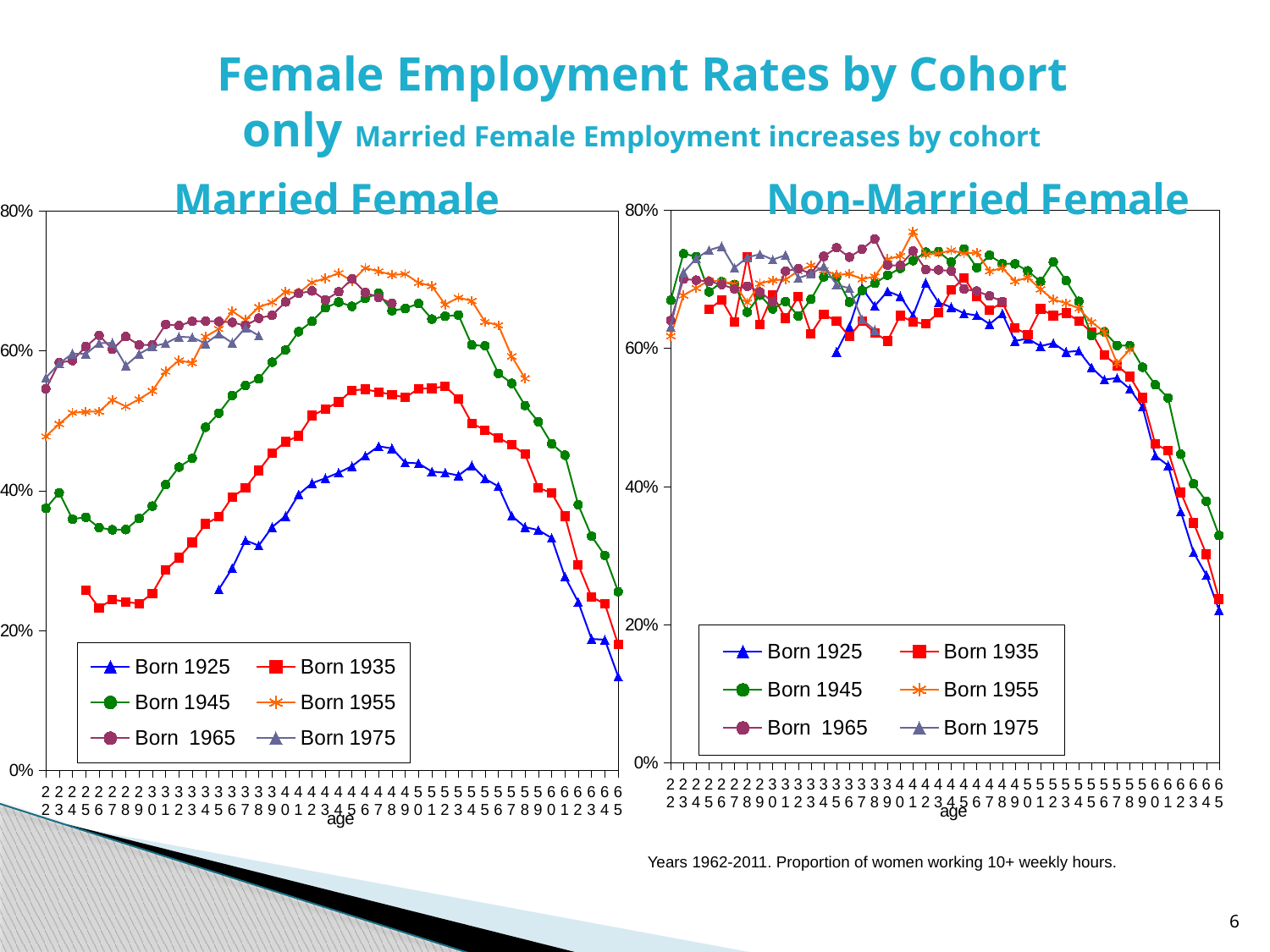
What kind of chart is the Married Female chart? line chart How many series does the legend of the Non-Married Female chart list? 6 In the Non-Married Female chart, which is larger at age 65: Born 1945 or Born 1925? Born 1945 In the Married Female chart, which is larger at age 40: Born 1945 or Born 1935? Born 1945 In the Married Female chart, does the Born 1935 series rise or fall between age 30 and age 45? rise In the Married Female chart, which series has the highest value at age 65? Born 1945 In the Married Female chart, is the value for Born 1955 at age 45 greater or less than 60%? greater In the Married Female chart, is the value for Born 1925 at age 65 greater or less than 20%? less In the Non-Married Female chart, is the value for Born 1945 at age 65 greater or less than 40%? less What is the x-axis label on the Married Female chart? age In the Non-Married Female chart, does the Born 1925 series rise or fall between age 55 and age 65? fall